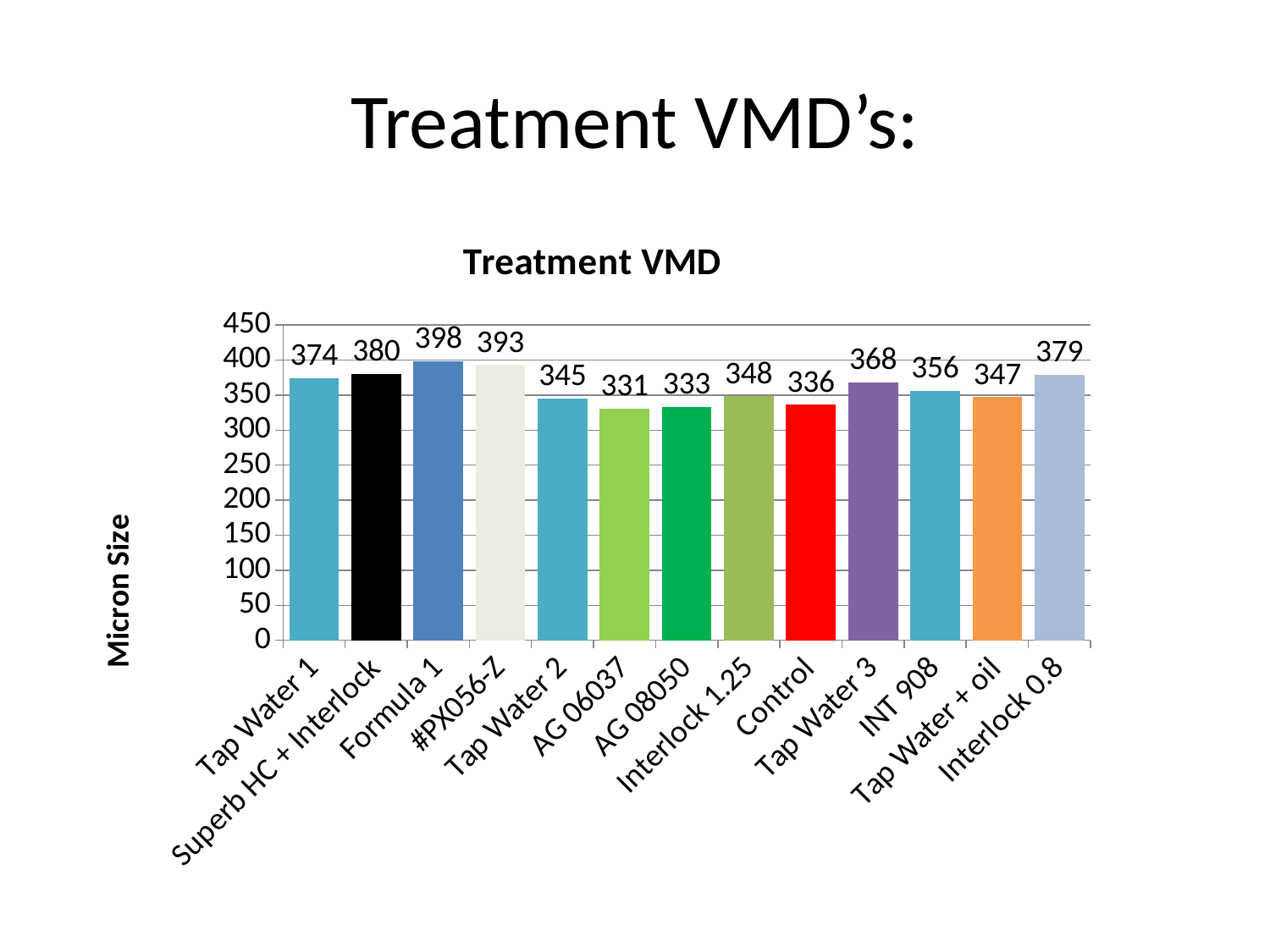
Which category has the highest value? Formula 1 How many categories are shown on the x axis? 13 What kind of chart is shown? bar chart What is the difference between the values for Superb HC + Interlock and Control? 44 What is the value for Control? 336 What is the value for Tap Water + oil? 347 What is the difference between the values for Formula 1 and AG 06037? 67 Which is larger, the value for #PX056-Z or the value for Interlock 0.8? #PX056-Z What is the value for Formula 1? 398 What is the label of the vertical axis? Micron Size Is the value for Tap Water 3 greater or less than 350? greater Which category has the lowest value? AG 06037